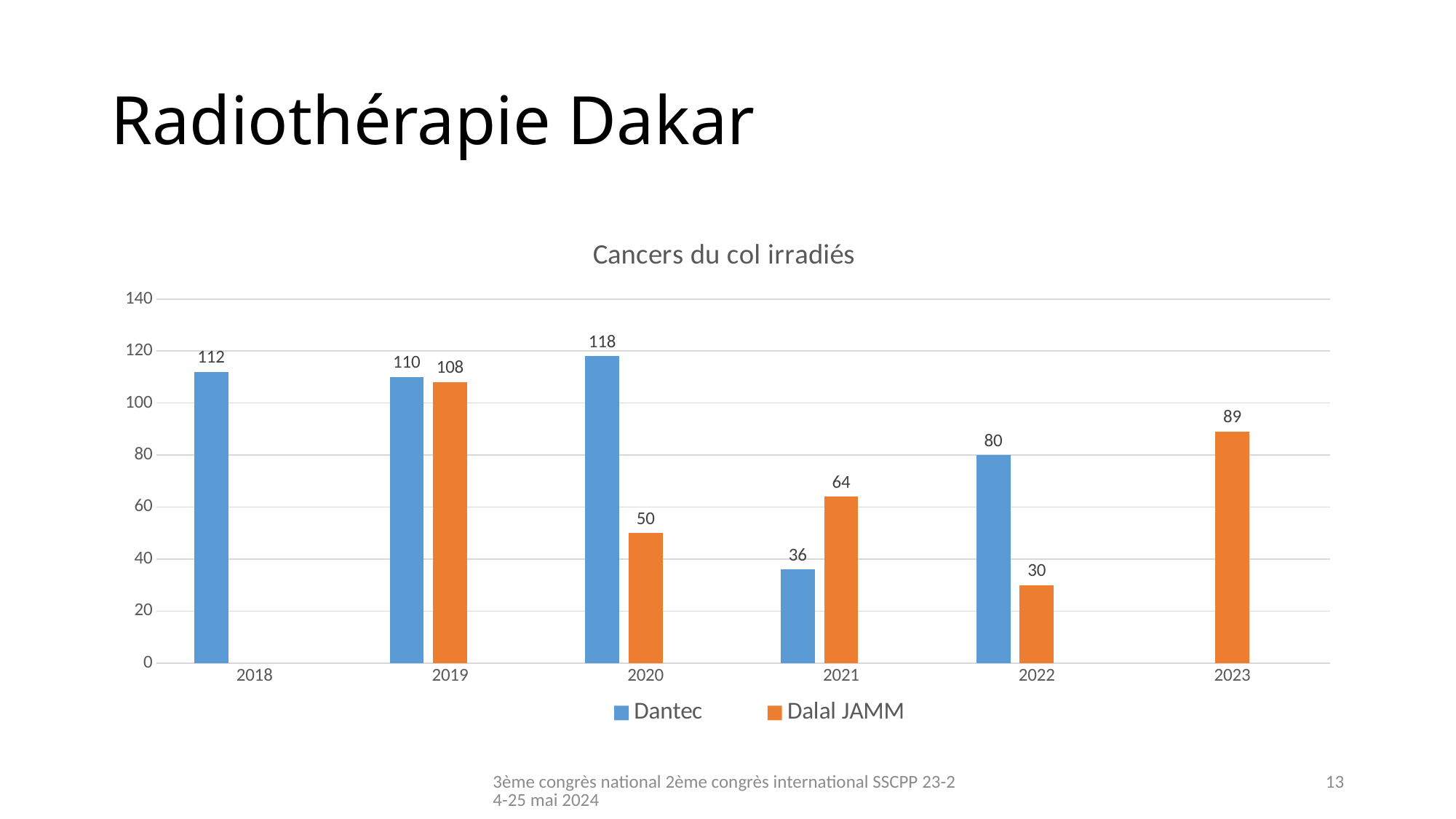
In which year is the Dantec value lowest? 2021 What is the value for Dalal JAMM in 2021? 64 Which is larger in 2022, Dantec or Dalal JAMM? Dantec What is the title of the chart? Cancers du col irradiés What is the value for Dalal JAMM in 2023? 89 How many years are shown on the x axis? 6 How many series does the legend list? 2 What is the value for Dantec in 2020? 118 In which year is the Dantec value highest? 2020 What is the difference between the Dantec and Dalal JAMM values in 2020? 68 What kind of chart is shown on the slide? Bar chart Is the value for Dantec in 2018 greater or less than 100? greater